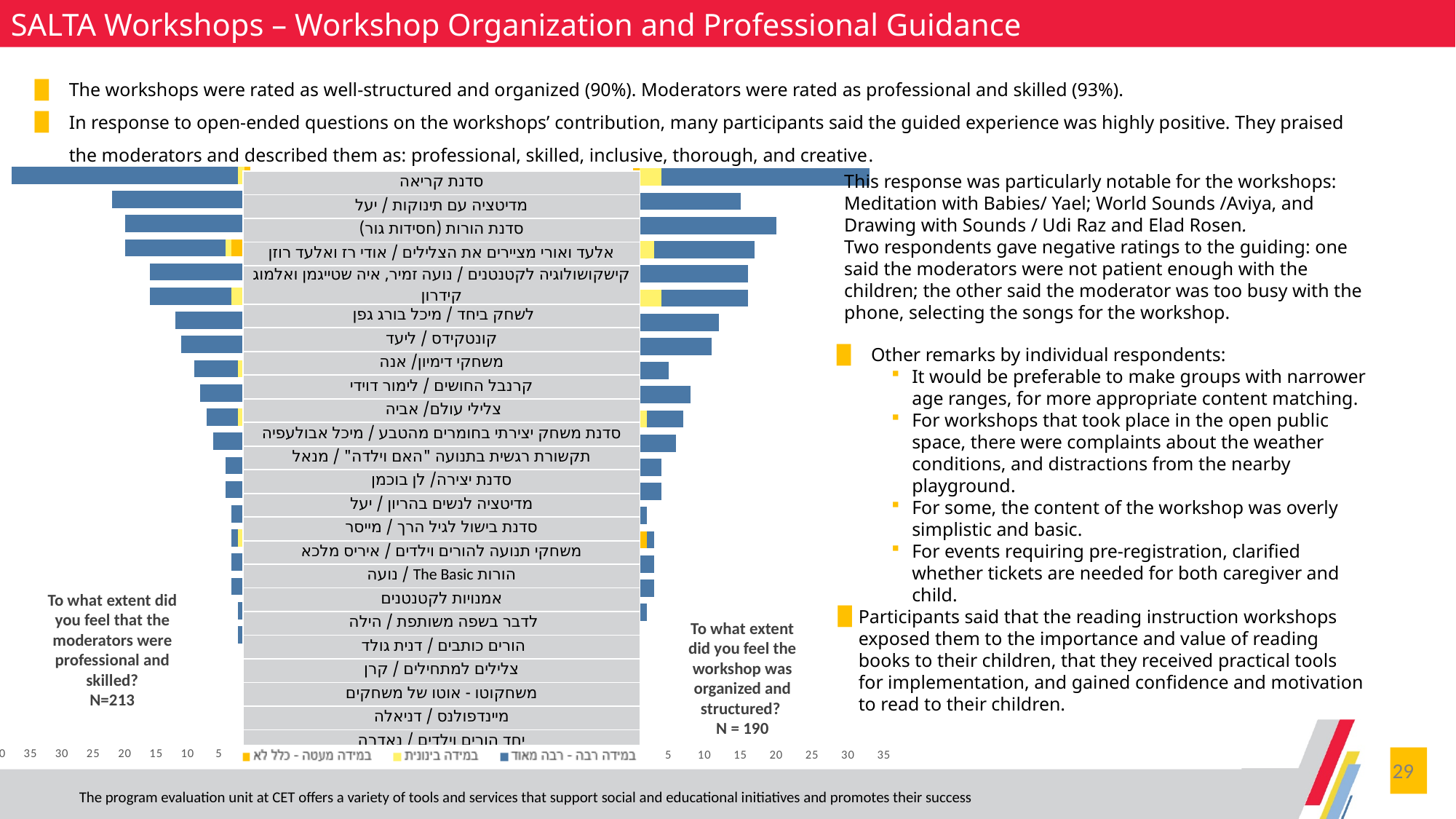
In the right chart (workshop organized and structured), is the value for סדנת הורות (חסידות גור) greater or less than 15? greater In the right chart (workshop organized and structured), is the total bar for סדנת קריאה greater or less than 20? greater In the left chart (moderators professional and skilled), is the value for מדיטציה עם תינוקות / יעל greater or less than 10? greater How many workshops are listed as categories in the charts? 24 In the left chart (moderators professional and skilled), which workshop has the longest bar? סדנת קריאה In the right chart (workshop organized and structured), which workshop has the longest bar? סדנת קריאה What is the N (number of respondents) shown for the right chart about the workshop being organized and structured? N = 190 What kind of chart is used on this slide? bar chart In the left chart (moderators professional and skilled), which has the larger value: סדנת קריאה or מדיטציה עם תינוקות / יעל? סדנת קריאה How many series does the legend list? 3 What is the N (number of respondents) shown for the left chart about moderators being professional and skilled? N=213